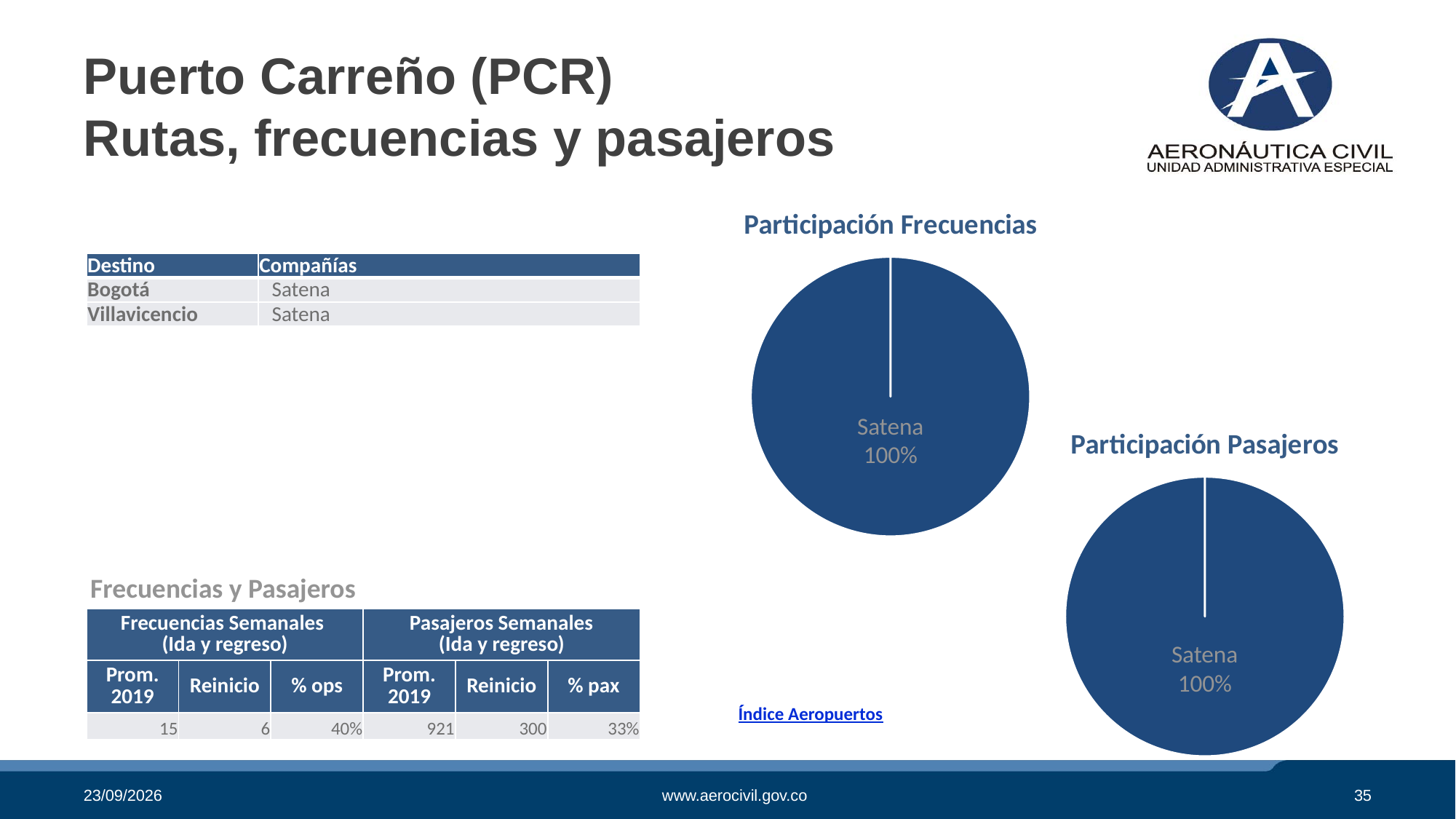
What kind of chart is 'Participación Frecuencias'? Pie chart In the 'Participación Frecuencias' chart, what share does Satena hold? 100% What kind of chart is 'Participación Pasajeros'? Pie chart How many slices does the 'Participación Frecuencias' pie chart have? 1 How many slices does the 'Participación Pasajeros' pie chart have? 1 Which company is shown in the 'Participación Frecuencias' chart? Satena What is the title of the pie chart in the upper right of the slide? Participación Frecuencias In the 'Participación Pasajeros' chart, what share does Satena hold? 100% How many pie charts are on the slide? 2 What is the title of the pie chart in the lower right of the slide? Participación Pasajeros Which company is shown in the 'Participación Pasajeros' chart? Satena